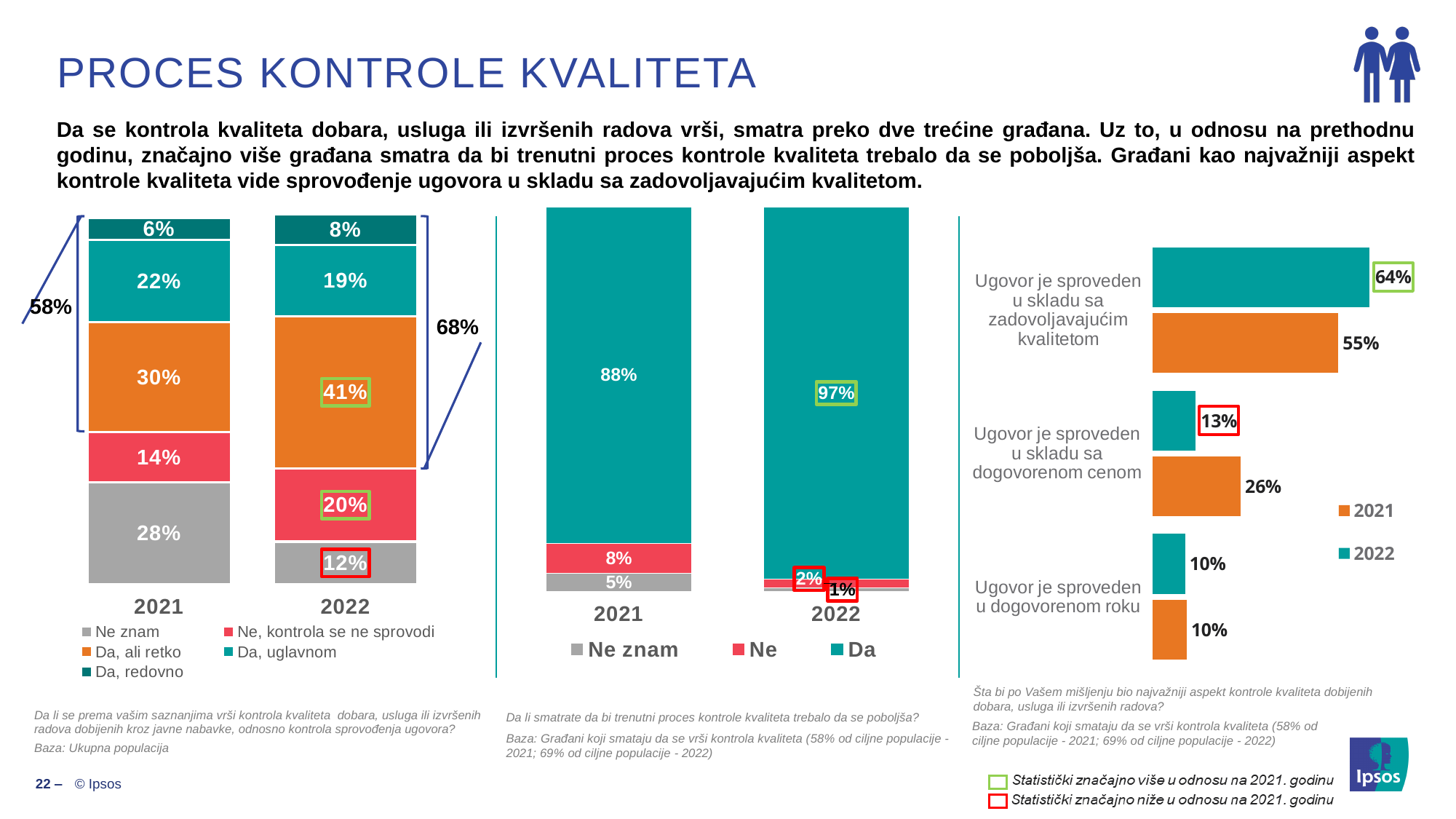
In the middle stacked bar chart, what is the value for "Ne" in 2021? 8% In the right chart, which category has the highest 2021 value? Ugovor je sproveden u skladu sa zadovoljavajućim kvalitetom In the left stacked bar chart, how many series does the legend list? 5 In the left stacked bar chart, what is the value for "Ne znam" in 2021? 28% What kind of chart is the right chart? Bar chart In the middle stacked bar chart, which year has the larger "Da" value, 2021 or 2022? 2022 In the middle stacked bar chart, what is the value for "Da" in 2022? 97% In the right chart, what is the difference between the 2021 and 2022 values for "Ugovor je sproveden u skladu sa dogovorenom cenom"? 13% In the middle stacked bar chart, how many series does the legend list? 3 In the right chart, what is the 2022 value for "Ugovor je sproveden u skladu sa zadovoljavajućim kvalitetom"? 64% In the left stacked bar chart, what is the difference between the "Da, uglavnom" values for 2021 and 2022? 3% In the left stacked bar chart, what is the value for "Da, ali retko" in 2022? 41%